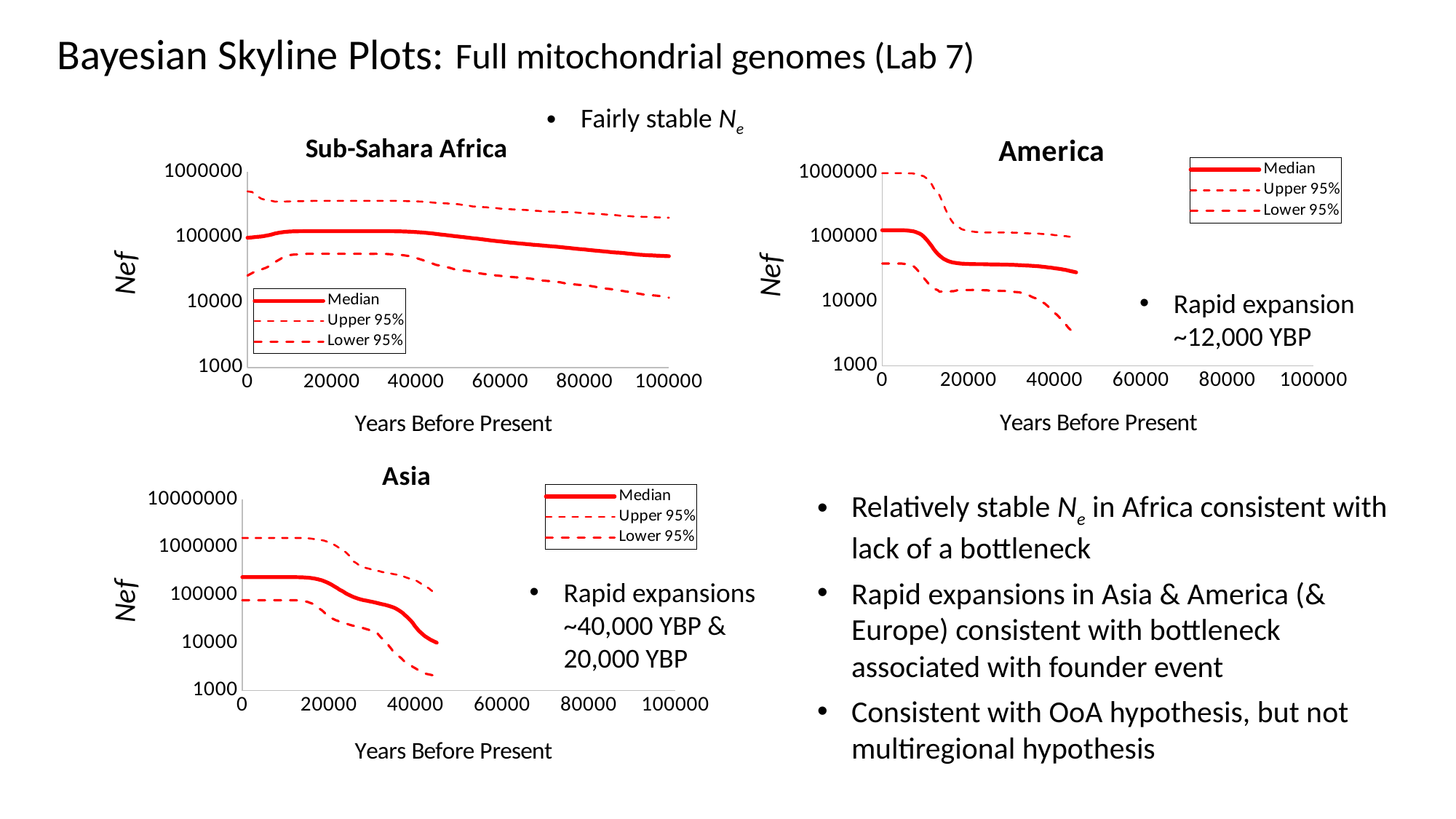
What is the y-axis label of the Sub-Sahara Africa chart? Nef In the Sub-Sahara Africa chart, is the Median value larger at 20000 or at 100000 years before present? 20000 In the Asia chart, does the Median line rise or fall as years before present increase? fall In the Sub-Sahara Africa chart, is the Upper 95% value at 0 years before present greater or less than 1000000? less In the America chart, is the Median value at 40000 years before present greater or less than 100000? less How many series does the legend of the America chart list? 3 What kind of chart is the Sub-Sahara Africa chart? line chart What is the x-axis title of the Asia chart? Years Before Present In the Asia chart, is the Lower 95% value at 40000 years before present greater or less than 10000? less In the America chart, does the Median line rise or fall as years before present increase? fall